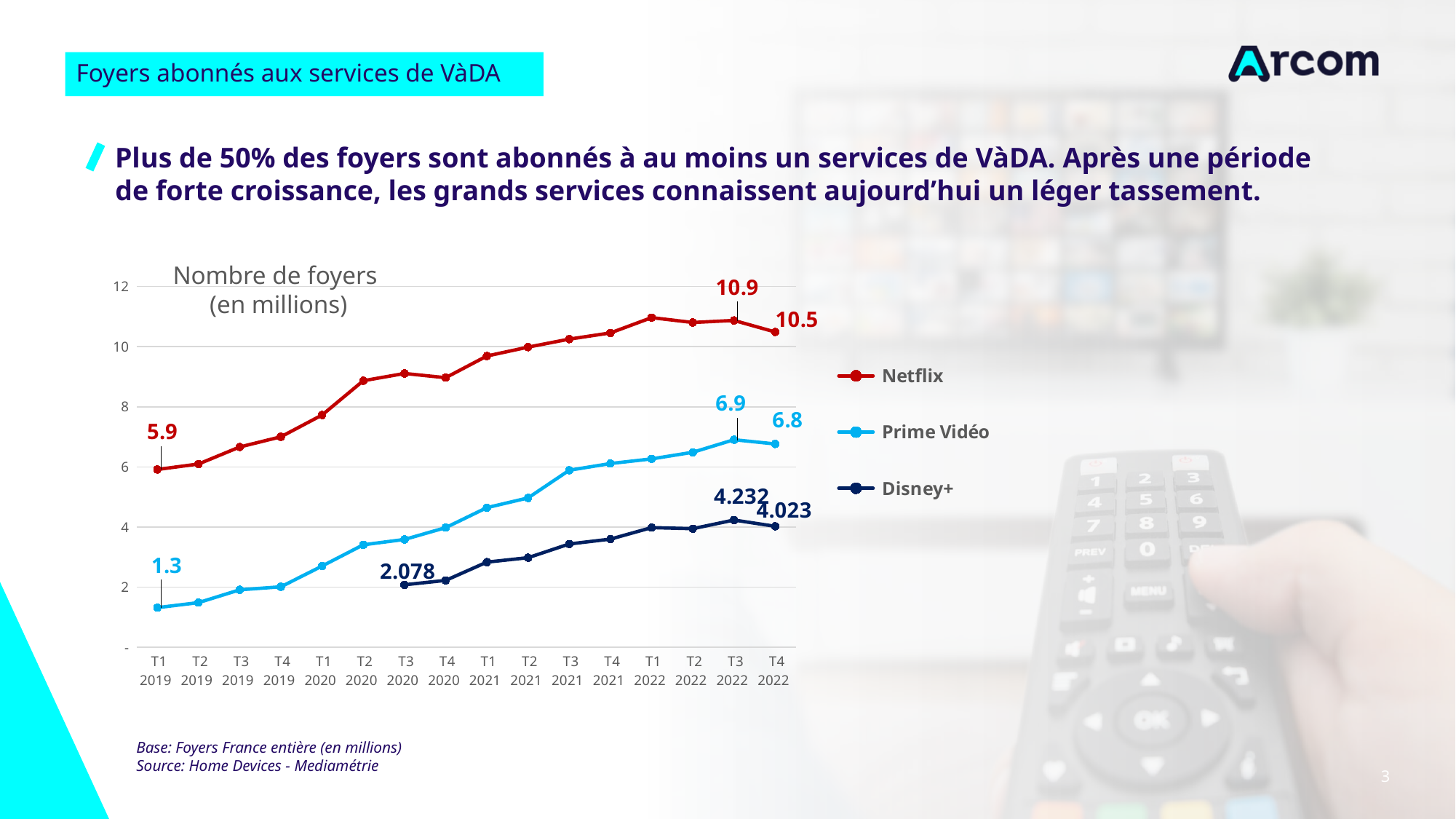
What is the value for Netflix in T1 2019? 5.9 What is the difference between the Netflix values in T3 2022 and T4 2022? 0.4 What is the value for Disney+ in T3 2022? 4.232 Is the value for Netflix in T1 2020 greater or less than 6? greater Which service has the highest value in T4 2022? Netflix By how much did Prime Vidéo grow from T1 2019 to T3 2022? 5.6 What is the title of the chart? Nombre de foyers (en millions) What is the value for Disney+ in T3 2020? 2.078 What is the value for Prime Vidéo in T4 2022? 6.8 How many series does the legend list? 3 What type of chart is shown on the slide? line chart How many quarters (points) are shown along the x axis? 16